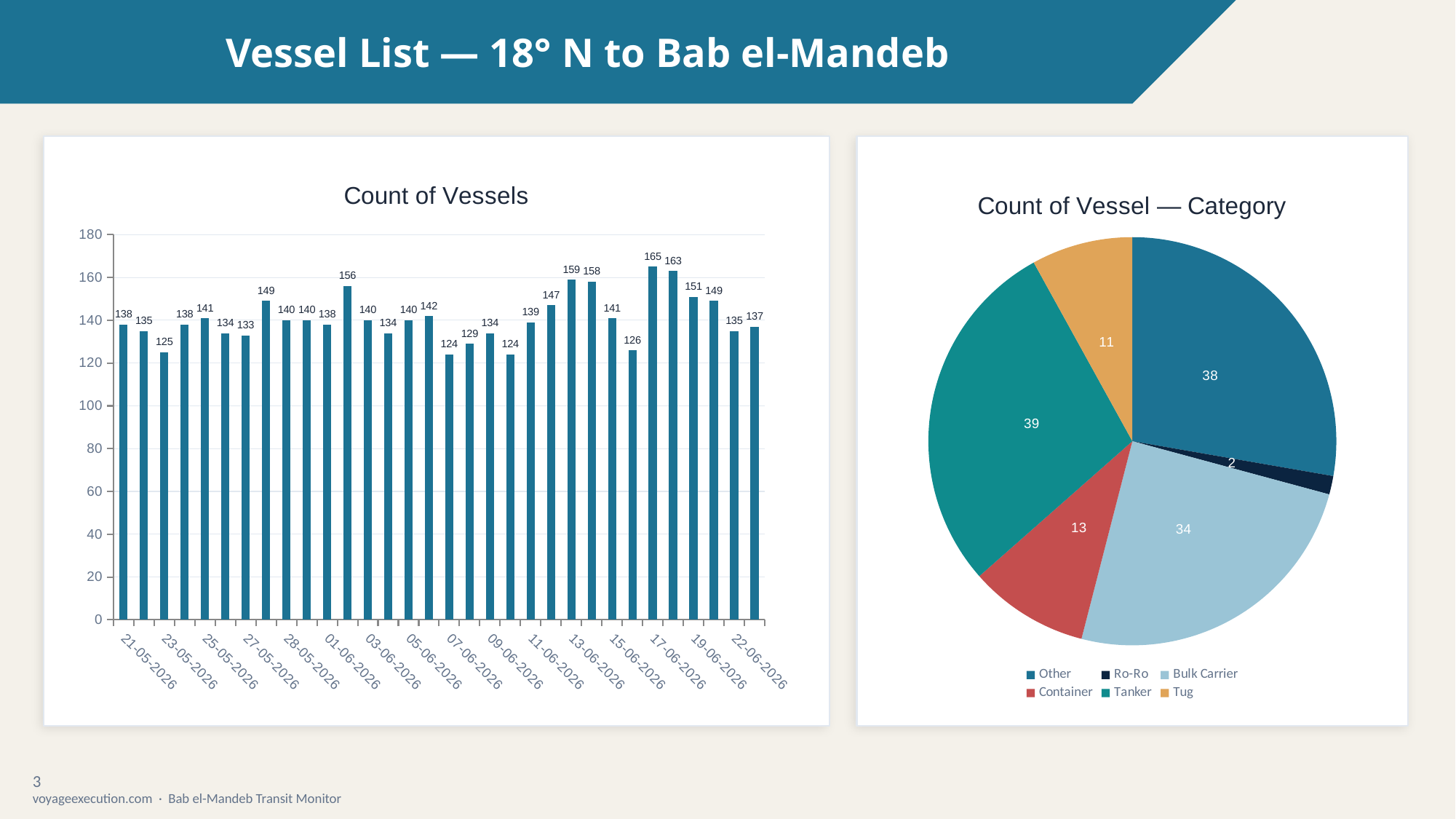
In the "Count of Vessel — Category" chart, which category has the smallest slice? Ro-Ro In the "Count of Vessels" chart, what is the difference between the highest value (165) and the lowest value (124)? 41 What kind of chart is the "Count of Vessels" chart on the left? bar chart In the "Count of Vessels" chart, is the value for 21-05-2026 greater or less than 120? greater In the "Count of Vessels" chart, what is the highest value shown? 165 In the "Count of Vessel — Category" chart, what is the value for Bulk Carrier? 34 In the "Count of Vessel — Category" chart, how many categories does the legend list? 6 In the "Count of Vessels" chart, how many bars are plotted? 32 In the "Count of Vessels" chart, what is the lowest value shown? 124 What kind of chart is "Count of Vessel — Category" on the right? pie chart In the "Count of Vessel — Category" chart, what is the difference between Tanker and Container? 26 In the "Count of Vessels" chart, what is the value for 21-05-2026? 138